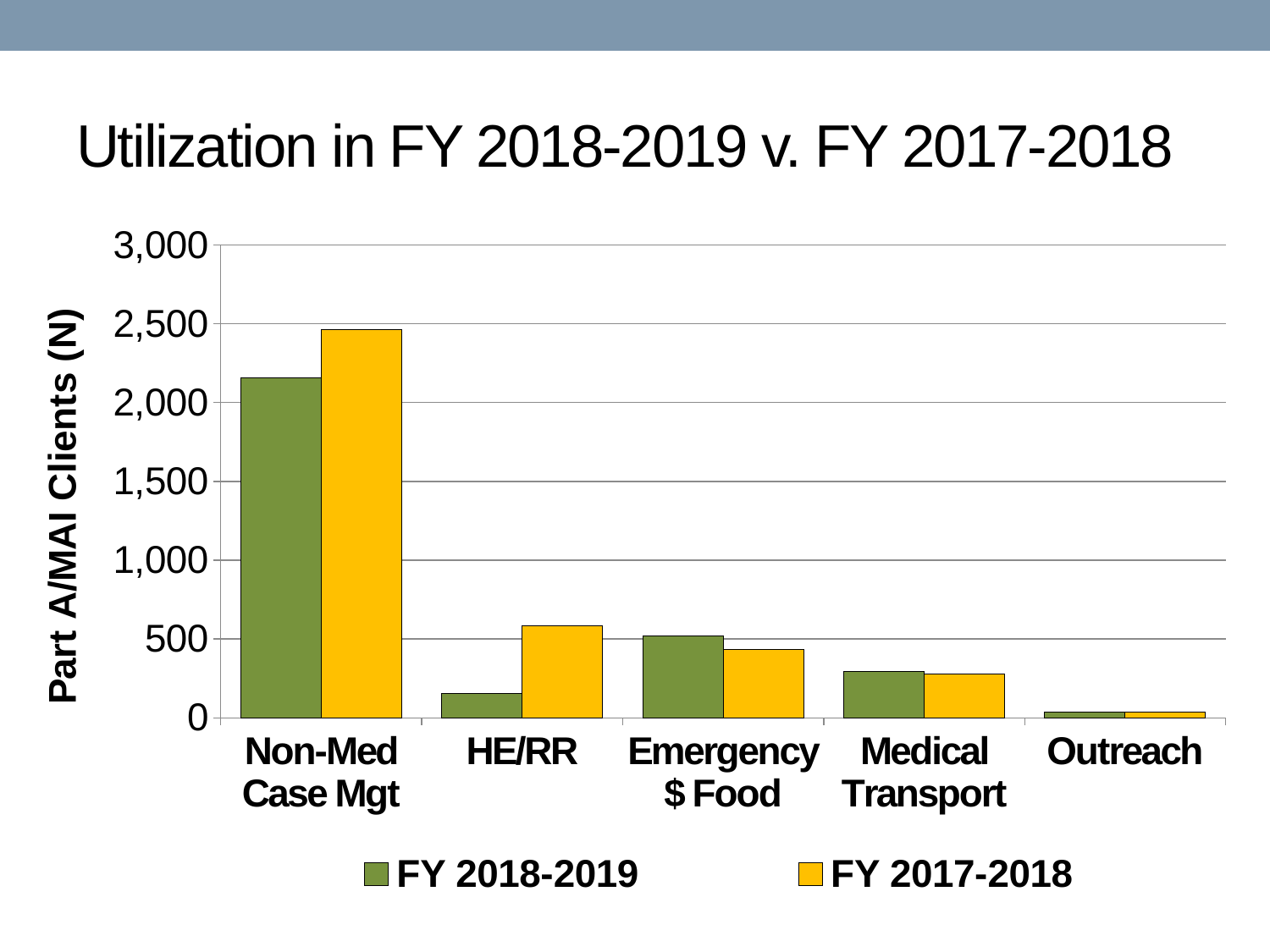
For HE/RR, which fiscal year had more clients, FY 2018-2019 or FY 2017-2018? FY 2017-2018 What kind of chart is shown on the slide? bar chart How many service categories are shown on the x axis? 5 For Emergency $ Food, which fiscal year had more clients, FY 2018-2019 or FY 2017-2018? FY 2018-2019 Is the FY 2018-2019 value for HE/RR greater or less than 500? less How many series does the legend list? 2 For Non-Med Case Mgt, which fiscal year had more clients, FY 2018-2019 or FY 2017-2018? FY 2017-2018 Which category has the highest number of Part A/MAI clients in FY 2017-2018? Non-Med Case Mgt Is the FY 2018-2019 value for Non-Med Case Mgt greater or less than 2,000? greater What is the label of the y axis? Part A/MAI Clients (N) Which category has the lowest number of Part A/MAI clients in FY 2018-2019? Outreach